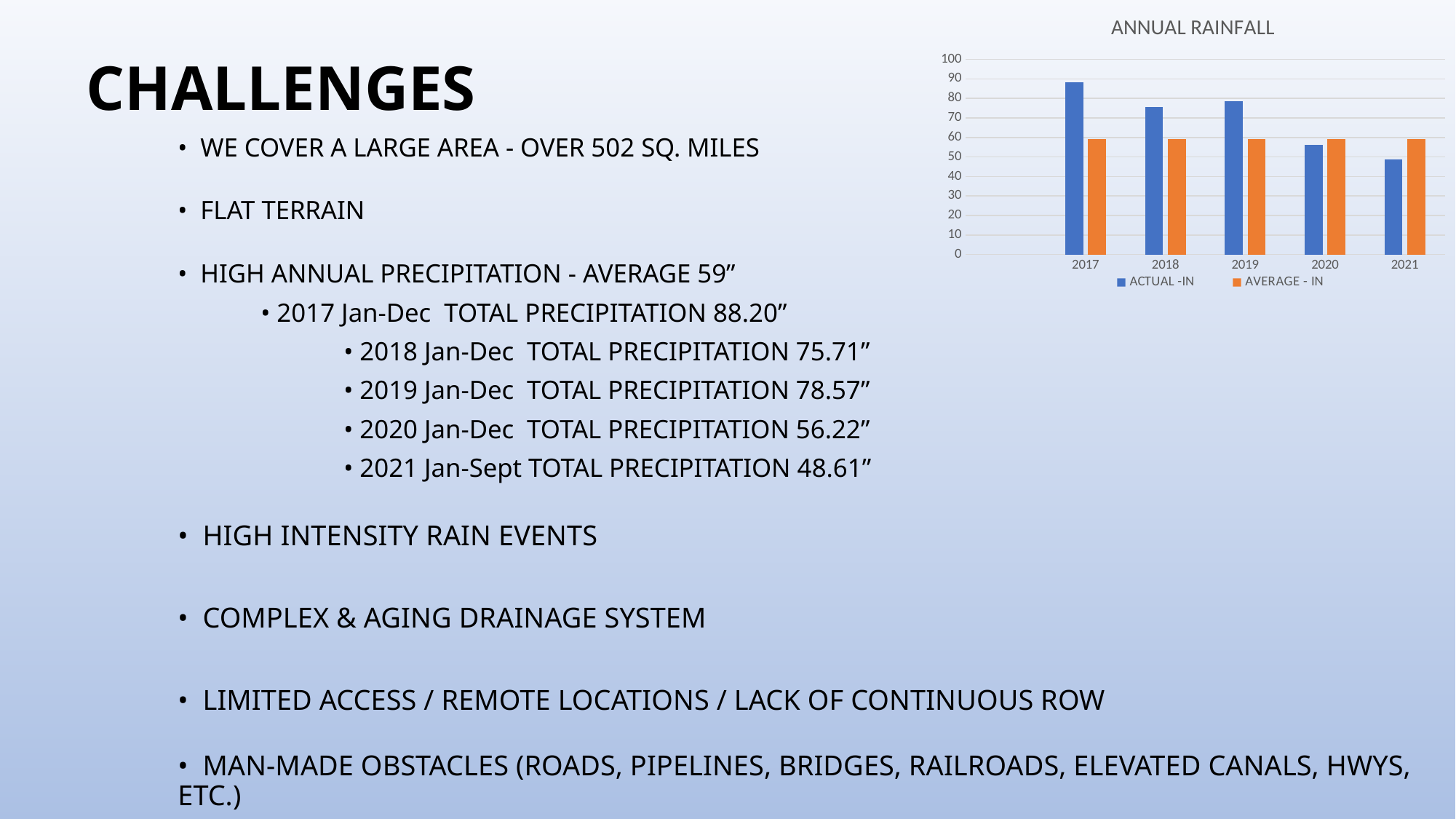
Which year has the lowest ACTUAL -IN bar? 2021 In 2021, which series has the taller bar, ACTUAL -IN or AVERAGE - IN? AVERAGE - IN Is the ACTUAL -IN value for 2020 greater or less than 60? less What type of chart is shown on the slide? bar chart Is the ACTUAL -IN value for 2017 greater or less than 80? greater How many years are shown on the x axis of the chart? 5 How many series does the chart legend list? 2 Which is larger, the ACTUAL -IN value for 2017 or for 2020? 2017 Is the ACTUAL -IN value for 2019 greater or less than 70? greater Which colour represents the AVERAGE - IN series in the chart? orange Which year has the highest ACTUAL -IN bar? 2017 What is the title of the chart? ANNUAL RAINFALL